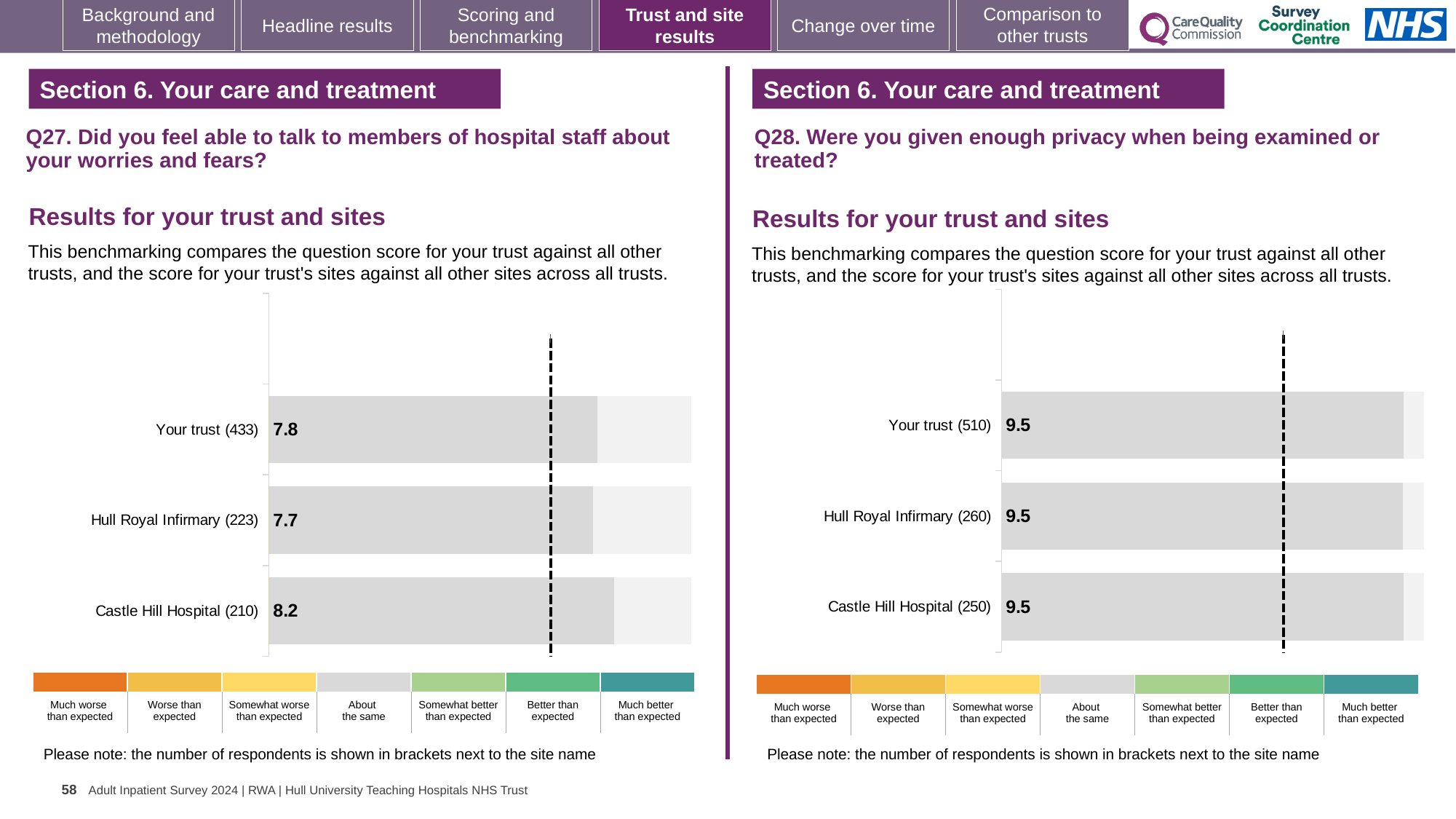
What kind of chart is the Q27 chart (left)? Bar chart On the Q27 chart (left), which site or trust has the lowest score? Hull Royal Infirmary On the Q27 chart (left), which has the larger score, Your trust or Castle Hill Hospital? Castle Hill Hospital On the Q27 chart (left), what is the score for Hull Royal Infirmary? 7.7 On the Q28 chart (right), how many respondents are shown in brackets for Hull Royal Infirmary? 260 On the Q28 chart (right), what is the score for Castle Hill Hospital? 9.5 On the Q27 chart (left), what is the score for Castle Hill Hospital? 8.2 On the Q28 chart (right), what is the score for Your trust? 9.5 On the Q27 chart (left), which site or trust has the highest score? Castle Hill Hospital On the Q27 chart (left), what is the score for Your trust? 7.8 On the Q28 chart (right), how many bars are plotted? 3 On the Q27 chart (left), what is the difference between the scores for Castle Hill Hospital and Hull Royal Infirmary? 0.5